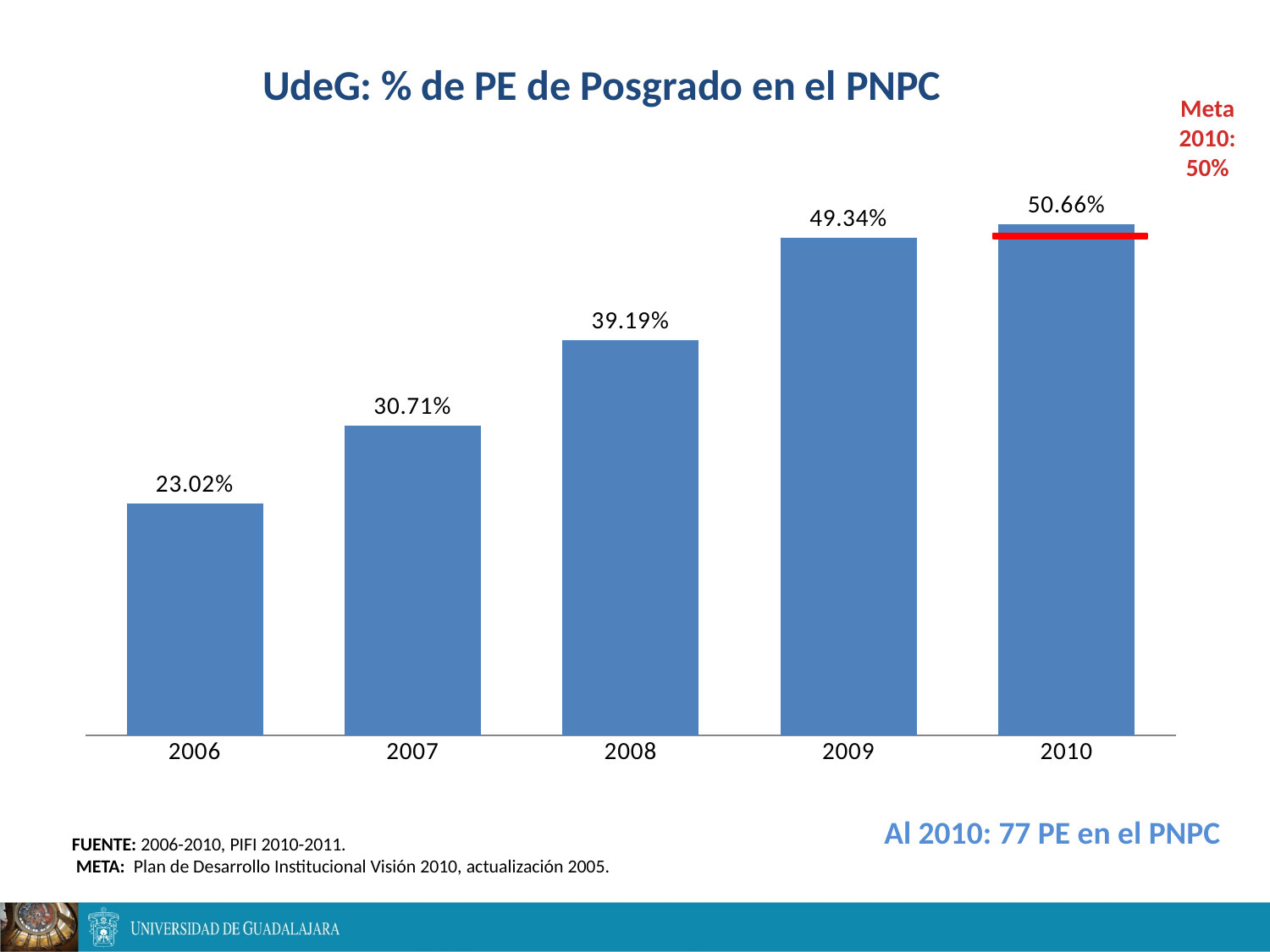
What is the value for 2010? 50.66% What is the value for 2008? 39.19% Which is larger, the value for 2008 or the value for 2007? 2008 Which year has the highest value? 2010 Which year has the lowest value? 2006 What is the title of the chart? UdeG: % de PE de Posgrado en el PNPC How many years are shown on the x axis? 5 What is the difference between the values for 2007 and 2006? 7.69% Do the values rise or fall from 2006 to 2010? Rise What is the value for 2006? 23.02% What kind of chart is shown? Bar chart What is the difference between the values for 2010 and 2009? 1.32%